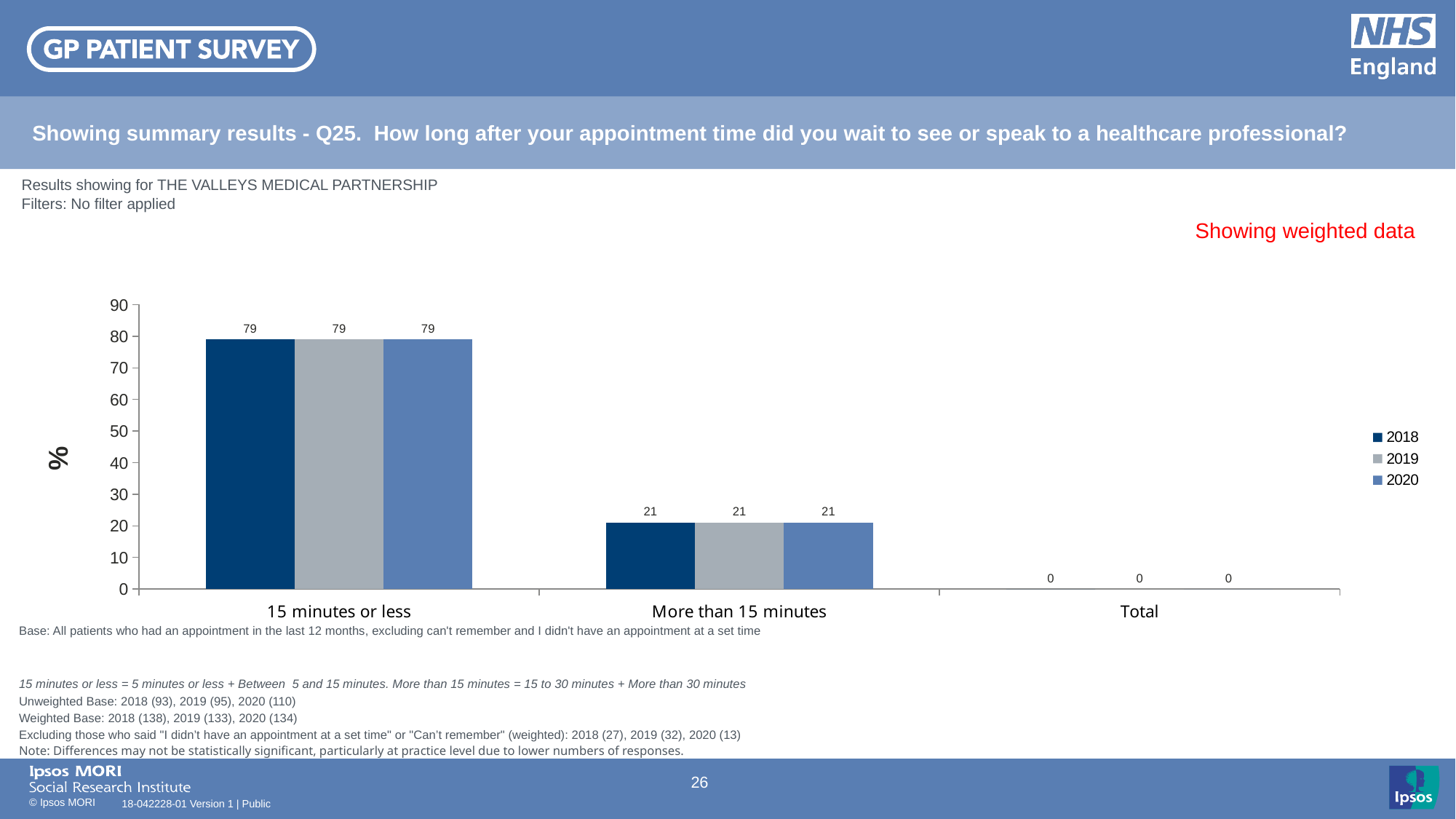
Which category has the lowest value for 2020? Total What is the value for 'More than 15 minutes' in 2018? 21 Is the value for '15 minutes or less' in 2019 greater or less than 70? greater How many series does the legend list? 3 What is the value for '15 minutes or less' in 2020? 79 What is the difference between '15 minutes or less' and 'More than 15 minutes' in 2018? 58 How many categories are shown on the x axis? 3 Which category has the highest value for 2019? 15 minutes or less What kind of chart is shown on the slide? bar chart What label is shown on the y axis? % What is the value for 'Total' in 2019? 0 Which is larger in 2020: '15 minutes or less' or 'More than 15 minutes'? 15 minutes or less